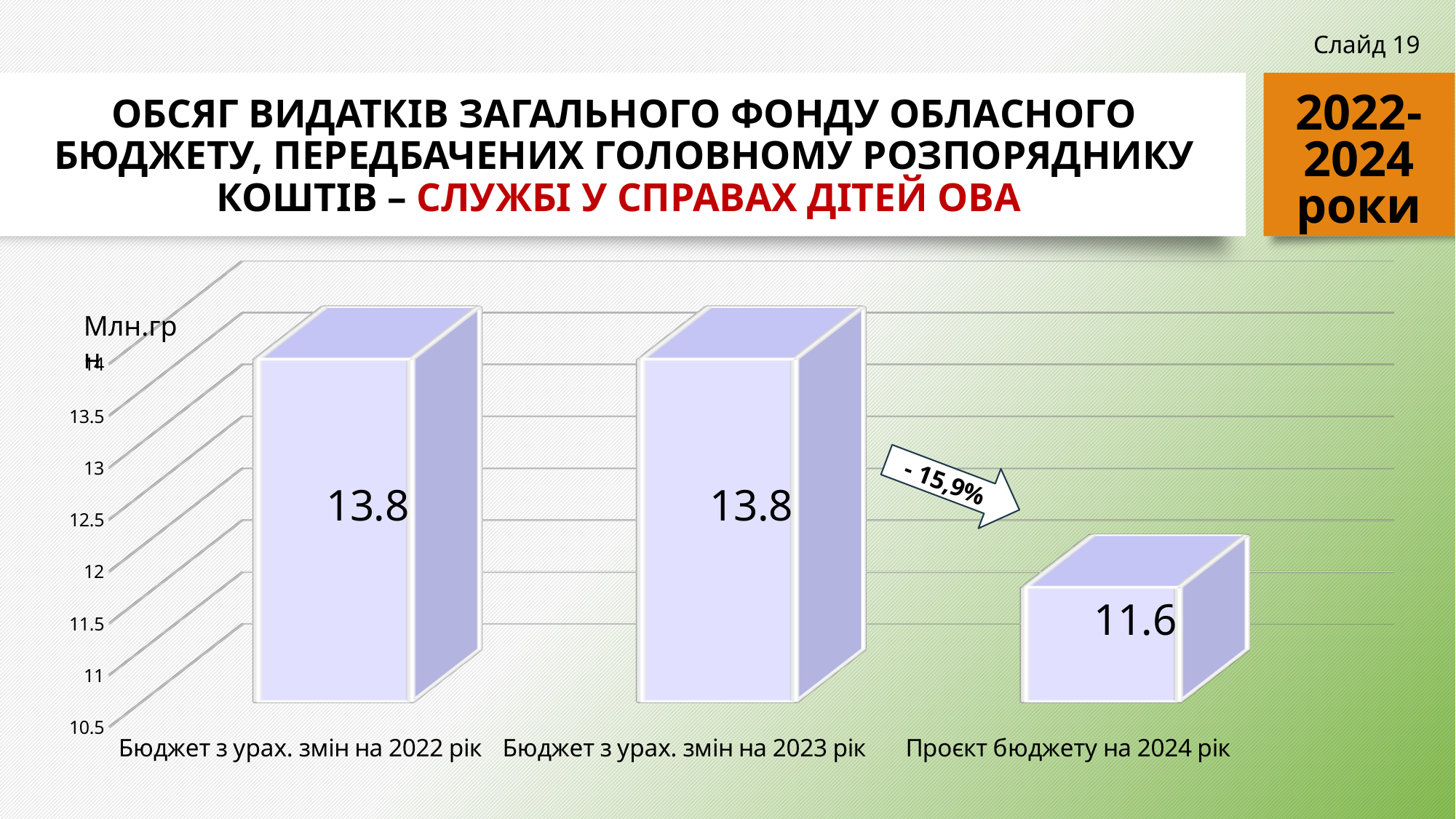
What is the value for "Проєкт бюджету на 2024 рік"? 11.6 How many categories are shown on the chart? 3 Which category has the lowest value? Проєкт бюджету на 2024 рік What is the value for "Бюджет з урах. змін на 2023 рік"? 13.8 What kind of chart is shown on the slide? bar chart What is the value for "Бюджет з урах. змін на 2022 рік"? 13.8 What is the difference between the value for "Бюджет з урах. змін на 2023 рік" and the value for "Проєкт бюджету на 2024 рік"? 2.2 Is the value for "Проєкт бюджету на 2024 рік" greater or less than 12? less Is the value for "Бюджет з урах. змін на 2023 рік" greater or less than 13? greater Which is larger: the value for "Бюджет з урах. змін на 2022 рік" or the value for "Проєкт бюджету на 2024 рік"? Бюджет з урах. змін на 2022 рік What unit is shown on the vertical axis of the chart? Млн.грн What percentage change is shown by the arrow between the 2023 and 2024 bars? - 15,9%